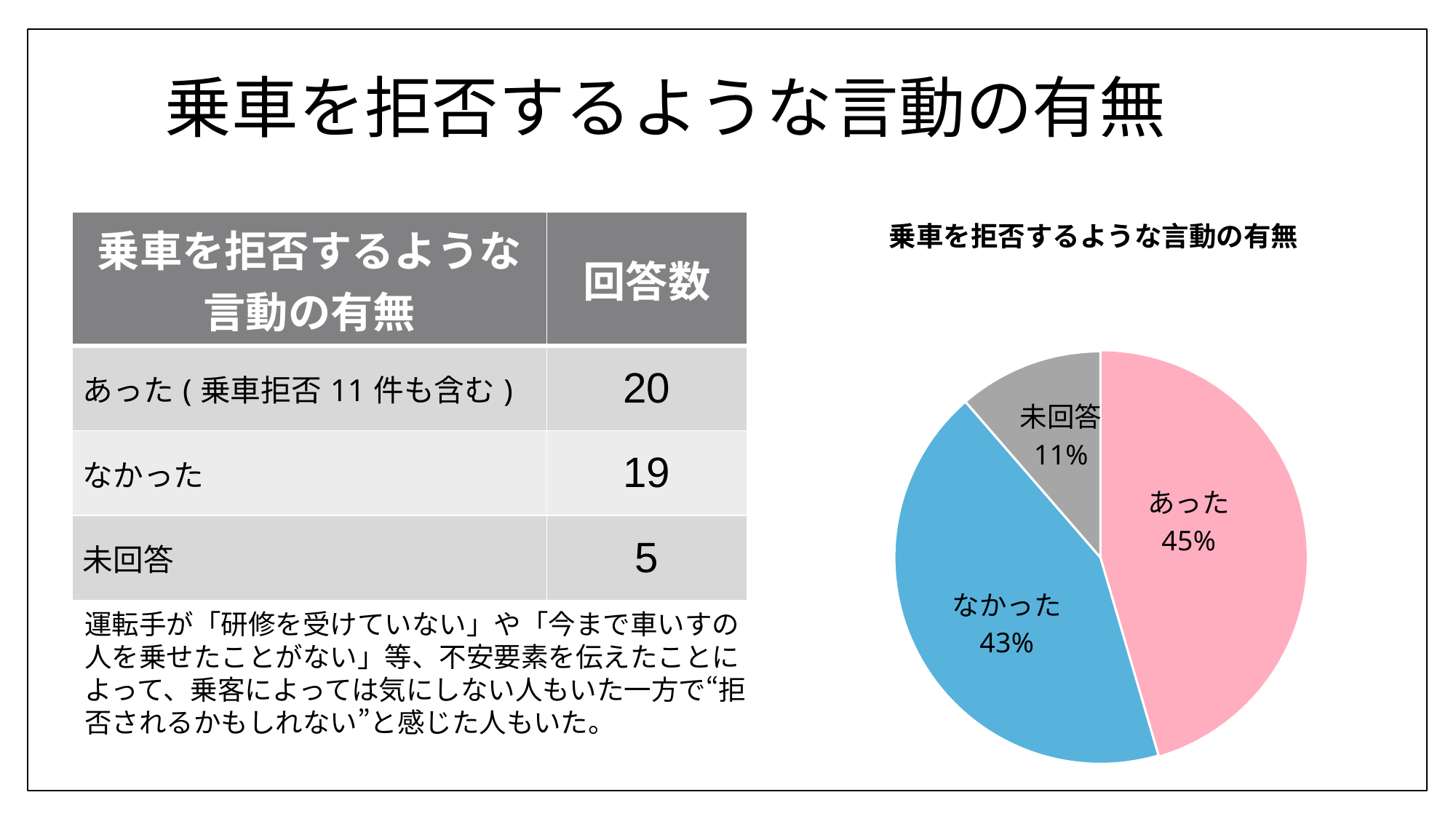
What kind of chart is shown on the slide? pie chart What is the title of the pie chart? 乗車を拒否するような言動の有無 What colour is the あった slice in the pie chart? pink By how many percentage points does なかった exceed 未回答 in the pie chart? 32 What share of the pie does なかった represent? 43% What percentage is shown for 未回答 in the pie chart? 11% Which slice of the pie chart is the largest? あった How many slices does the pie chart have? 3 Which is larger in the pie chart, なかった or 未回答? なかった By how many percentage points does あった exceed なかった in the pie chart? 2 What share of the pie does あった represent? 45% Which slice of the pie chart is the smallest? 未回答